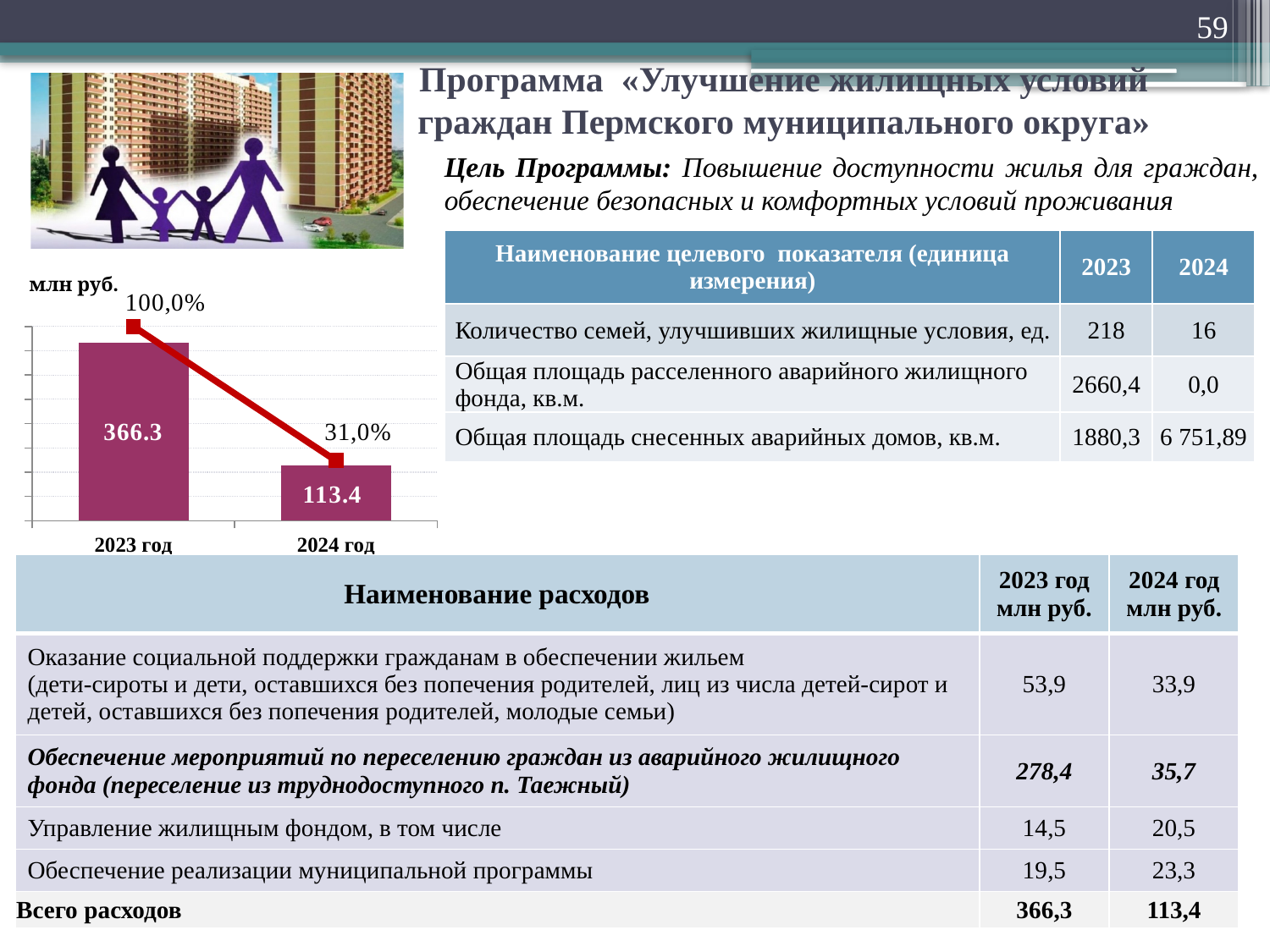
What is the difference between the 2023 год and 2024 год bar values in the chart? 252.9 Do the bar values rise or fall from 2023 год to 2024 год? fall How many bars (categories) are shown in the chart? 2 What percentage label is shown above the 2023 год bar on the line? 100,0% Which year has the lowest bar in the chart? 2024 год What is the value for 2024 год in the bar chart? 113.4 Which is larger in the chart, the value for 2023 год or for 2024 год? 2023 год What unit is indicated at the top left of the chart? млн руб. What percentage label is shown above the 2024 год bar on the line? 31,0% What kind of chart is shown on the left of the slide? combination bar and line chart Which year has the highest bar in the chart? 2023 год What is the value for 2023 год in the bar chart? 366.3